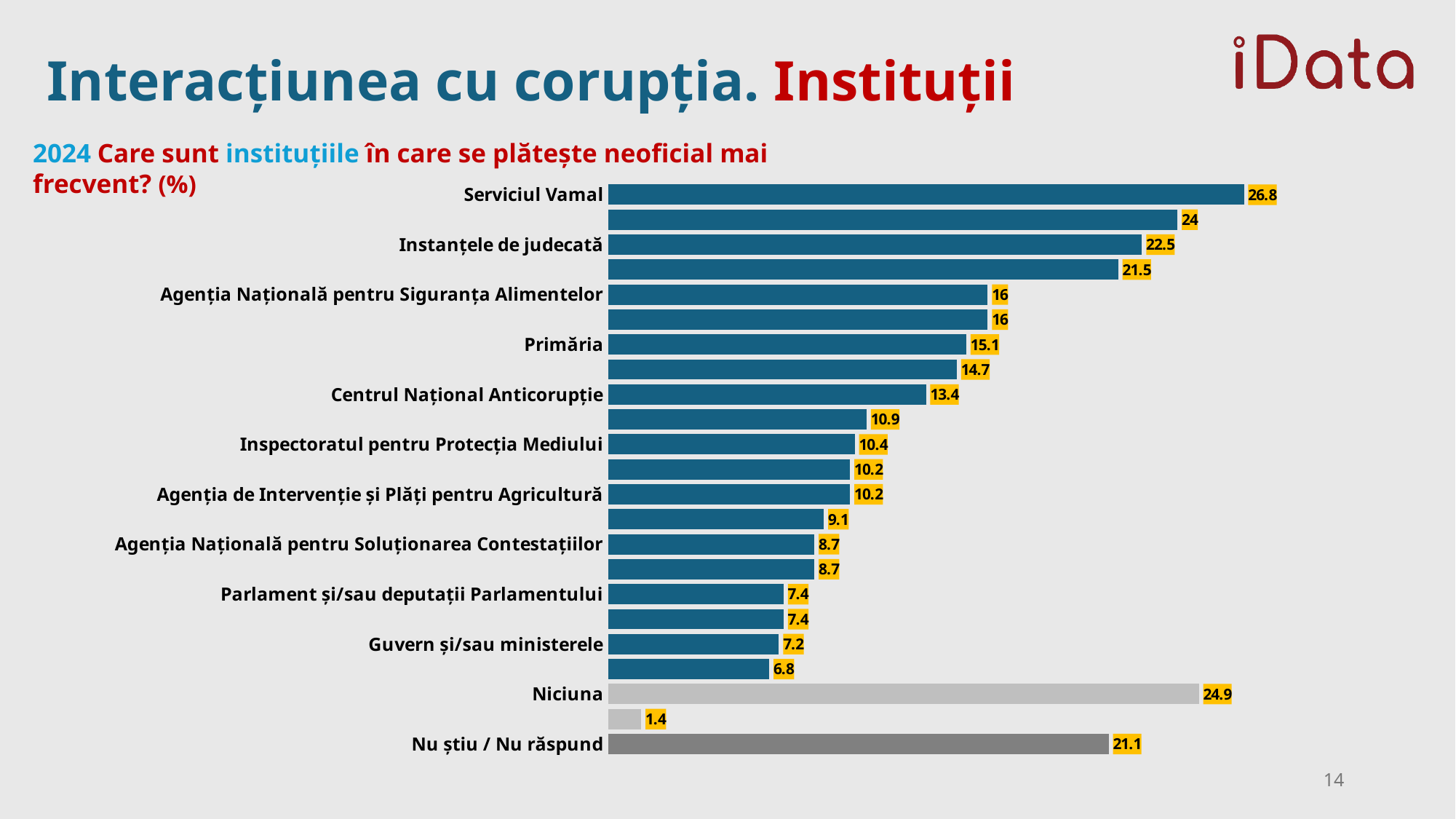
What is the value for Primăria? 15.1 Which category has the highest value in the chart? Serviciul Vamal How many bars are plotted in the chart? 23 What is the value for Instanțele de judecată? 22.5 What is the difference between the values for Niciuna and Nu știu / Nu răspund? 3.8 What is the difference between the values for Serviciul Vamal and Instanțele de judecată? 4.3 Which is larger, the value for Parlament și/sau deputații Parlamentului or the value for Guvern și/sau ministerele? Parlament și/sau deputații Parlamentului What kind of chart is shown on the slide? Bar chart What is the value for Niciuna? 24.9 What is the value for Centrul Național Anticorupție? 13.4 What is the value for Serviciul Vamal? 26.8 What is the value for Nu știu / Nu răspund? 21.1